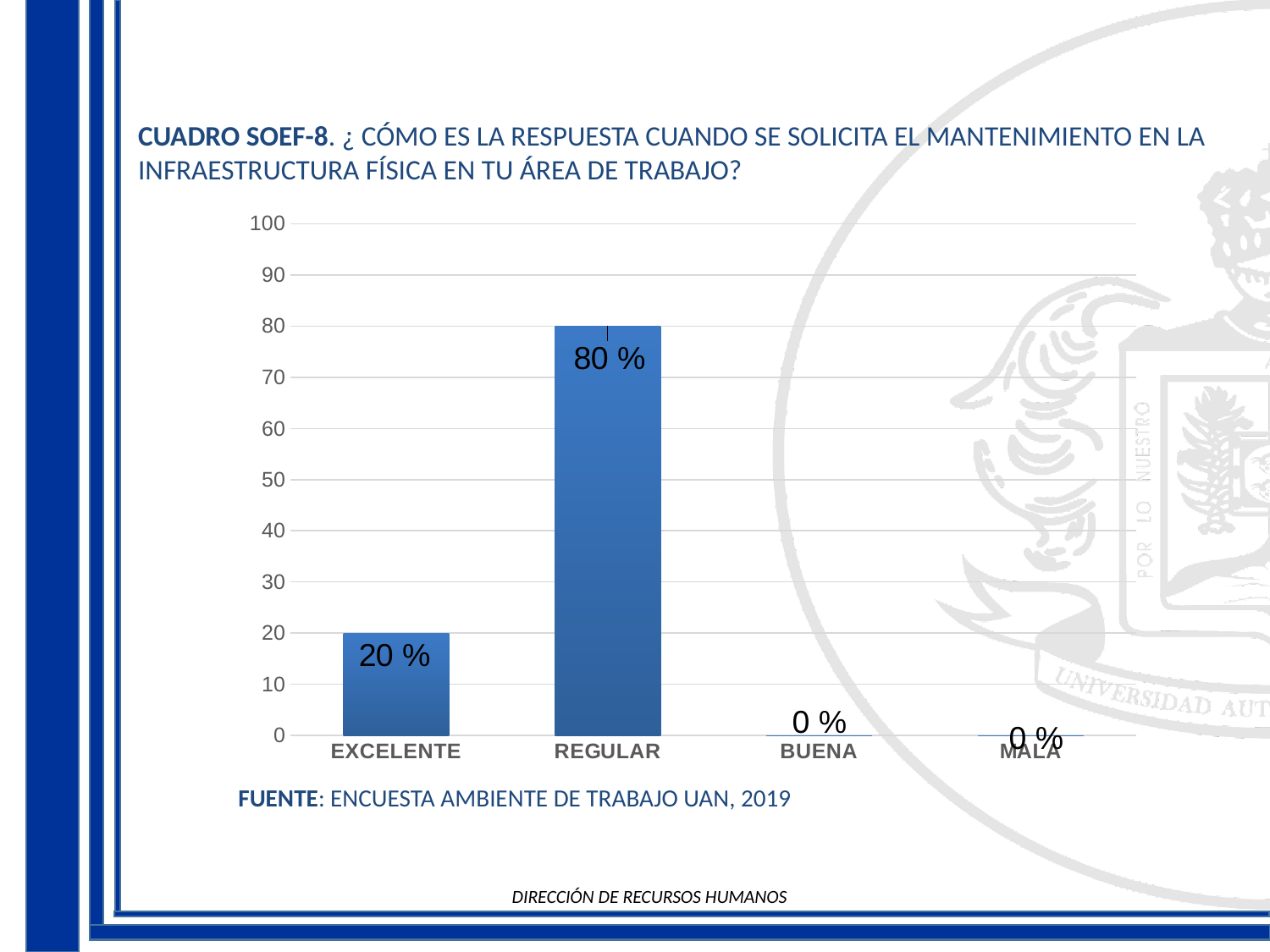
Is the value for REGULAR greater or less than 50? greater Which is larger, the value for EXCELENTE or the value for REGULAR? REGULAR Is the value for EXCELENTE greater or less than 30? less Which category has the highest value? REGULAR What is the source cited below the chart? ENCUESTA AMBIENTE DE TRABAJO UAN, 2019 What kind of chart is shown on the slide? bar chart What is the value for MALA? 0 % What is the value for EXCELENTE? 20 % What is the difference between the values for REGULAR and EXCELENTE? 60 % How many categories are shown on the x axis? 4 What is the value for REGULAR? 80 % What is the value for BUENA? 0 %